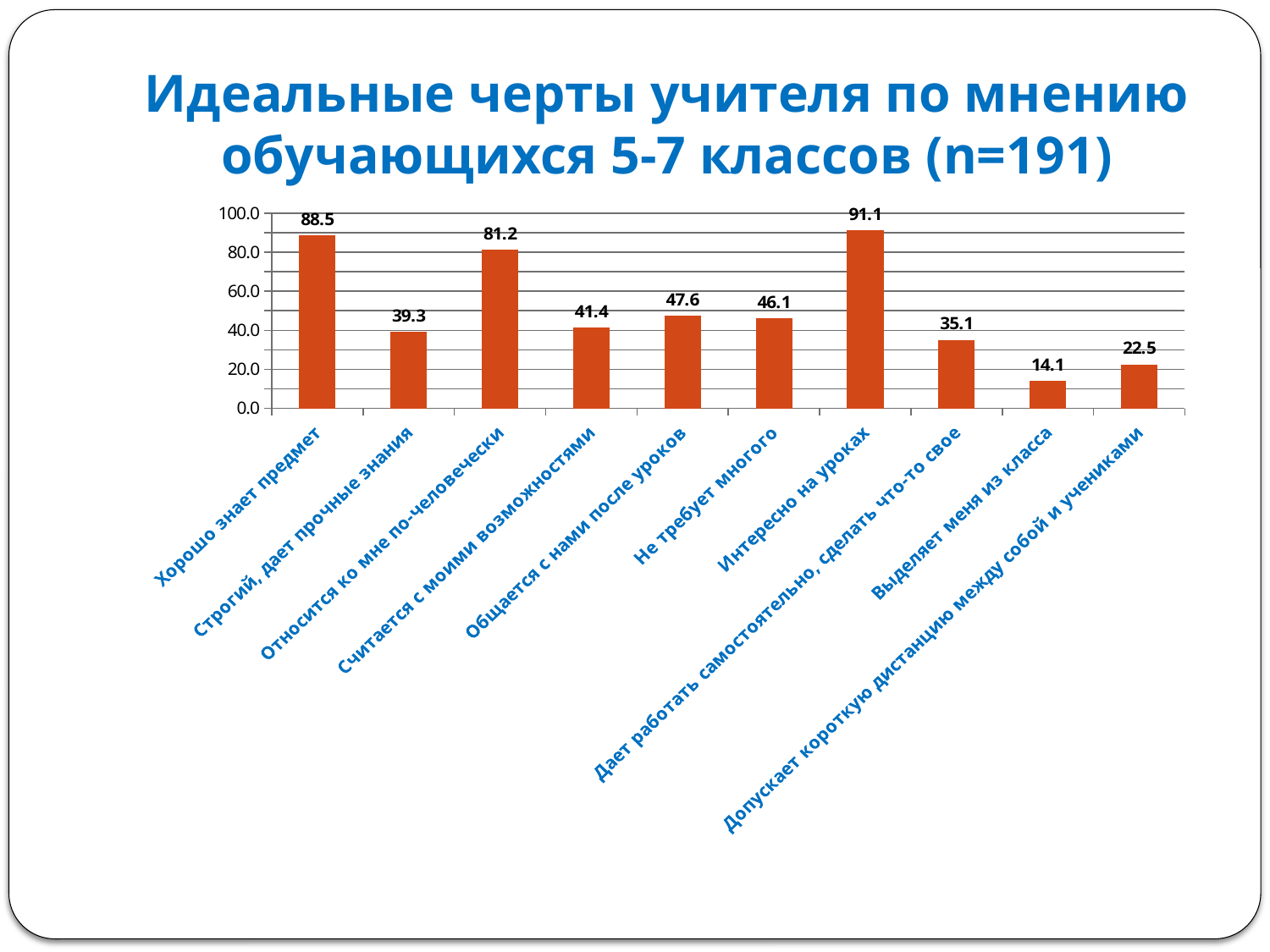
What is the sample size (n) stated in the chart title? 191 Which is larger: the value for "Строгий, дает прочные знания" or for "Считается с моими возможностями"? Считается с моими возможностями What is the difference between the values for "Интересно на уроках" and "Хорошо знает предмет"? 2.6 Which category has the highest value? Интересно на уроках How many categories are shown on the chart? 10 What value is shown for "Общается с нами после уроков"? 47.6 Is the value for "Относится ко мне по-человечески" greater or less than 80.0? greater What value is shown for "Выделяет меня из класса"? 14.1 What is the difference between the values for "Допускает короткую дистанцию между собой и учениками" and "Выделяет меня из класса"? 8.4 Which category has the lowest value? Выделяет меня из класса What kind of chart is shown on the slide? bar chart What value is shown for "Хорошо знает предмет"? 88.5